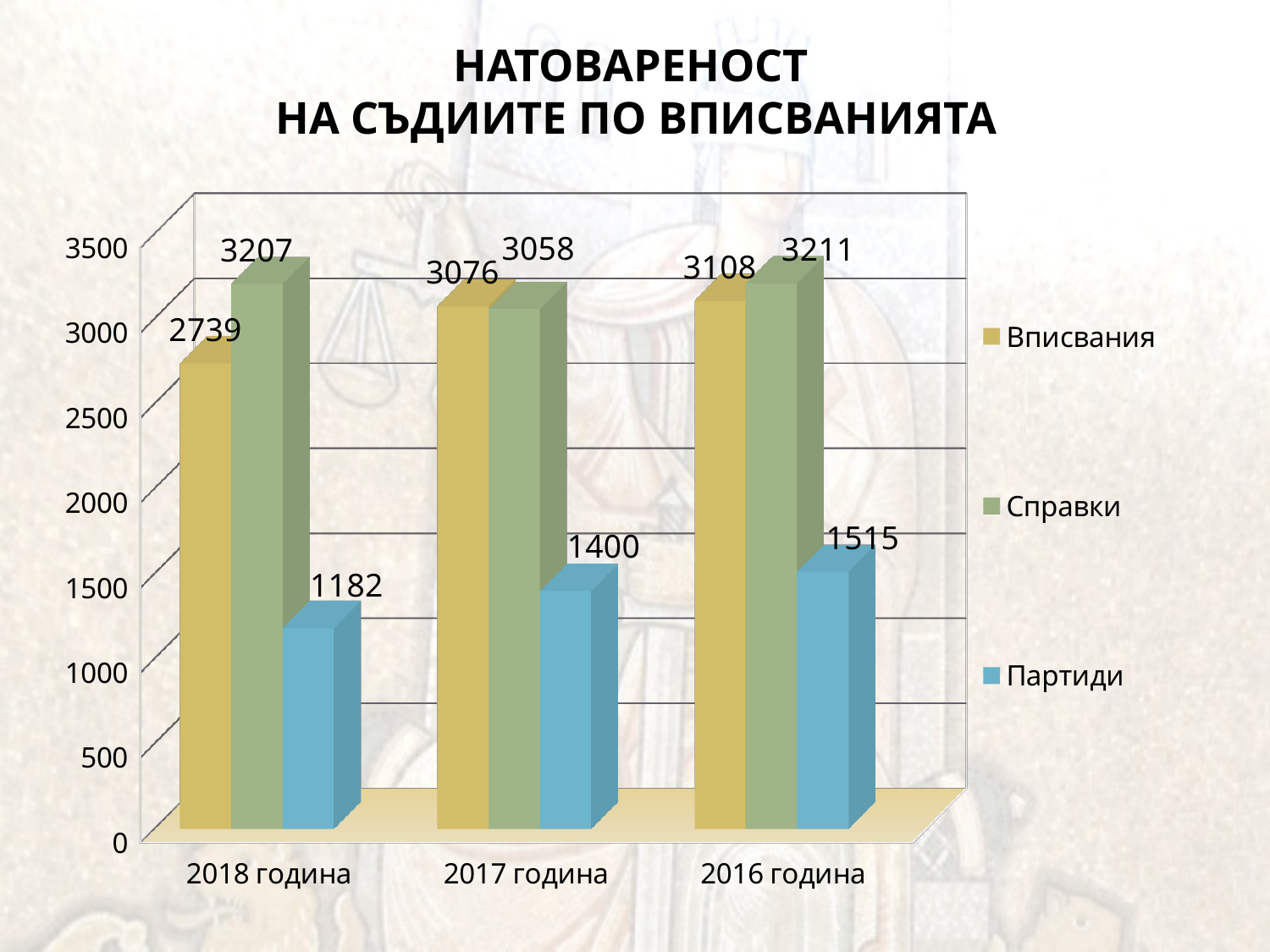
What is the difference between Справки and Вписвания in 2018 година? 468 Which year has the lowest value for Партиди? 2018 година Which colour represents Партиди in the legend? Blue What kind of chart is shown on the slide? Bar chart How many series does the legend list? 3 What is the value of Вписвания for 2018 година? 2739 How many year categories are shown on the x axis? 3 What is the value of Партиди for 2017 година? 1400 Which year has the highest value for Вписвания? 2016 година What is the value of Справки for 2016 година? 3211 What is the difference between Партиди in 2016 година and 2018 година? 333 Which is larger: Вписвания in 2017 година or Вписвания in 2018 година? 2017 година